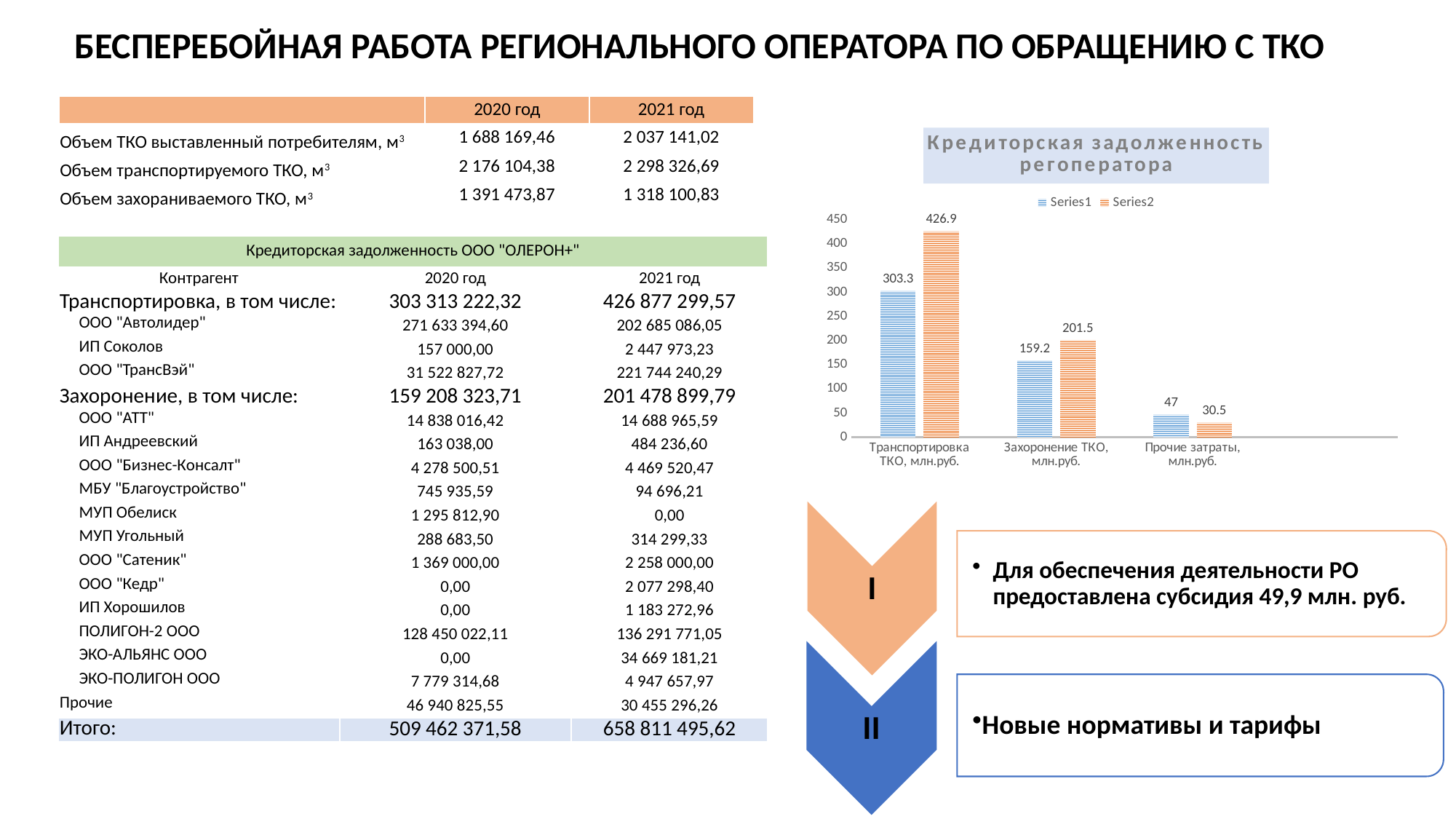
For "Прочие затраты, млн.руб.", which is larger: Series1 or Series2? Series1 How many categories are shown on the x axis of the chart? 3 What type of chart is shown under the title "Кредиторская задолженность регоператора"? bar chart What is the difference between the Series2 and Series1 values for "Транспортировка ТКО, млн.руб."? 123.6 What is the Series2 value for "Захоронение ТКО, млн.руб."? 201.5 How many series does the legend of the chart list? 2 Which category has the highest Series2 value? Транспортировка ТКО, млн.руб. Is the Series1 value for "Захоронение ТКО, млн.руб." greater or less than 200? less What is the Series1 value for "Транспортировка ТКО, млн.руб."? 303.3 Which category has the lowest Series1 value? Прочие затраты, млн.руб. What is the title of the chart on the slide? Кредиторская задолженность регоператора What is the Series2 value for "Прочие затраты, млн.руб."? 30.5